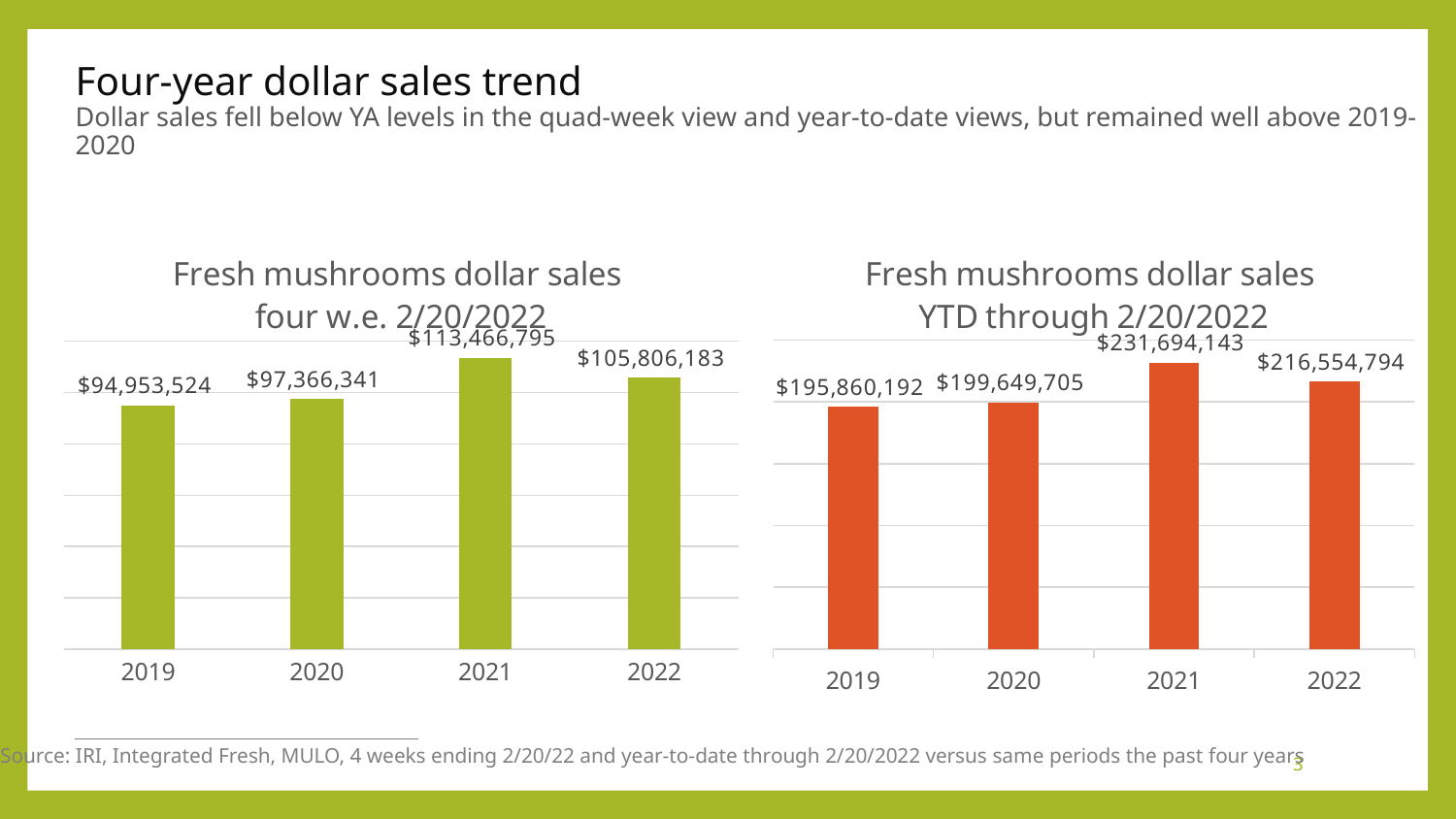
In the 'Fresh mushrooms dollar sales four w.e. 2/20/2022' chart, which year has the lowest value? 2019 In the 'Fresh mushrooms dollar sales four w.e. 2/20/2022' chart, do the values rise or fall from 2019 to 2021? Rise In the 'Fresh mushrooms dollar sales YTD through 2/20/2022' chart, which year has the highest value? 2021 How many years are shown in the 'Fresh mushrooms dollar sales four w.e. 2/20/2022' chart? 4 In the 'Fresh mushrooms dollar sales YTD through 2/20/2022' chart, which is larger, the value for 2020 or the value for 2022? 2022 In the 'Fresh mushrooms dollar sales four w.e. 2/20/2022' chart, what is the value for 2022? $105,806,183 In the 'Fresh mushrooms dollar sales YTD through 2/20/2022' chart, what is the value for 2019? $195,860,192 In the 'Fresh mushrooms dollar sales YTD through 2/20/2022' chart, what is the difference between the 2021 and 2022 values? $15,139,349 In the 'Fresh mushrooms dollar sales four w.e. 2/20/2022' chart, what is the difference between the 2021 and 2022 values? $7,660,612 What kind of chart is the 'Fresh mushrooms dollar sales YTD through 2/20/2022' chart? Bar chart What colour are the bars in the 'Fresh mushrooms dollar sales YTD through 2/20/2022' chart? Orange In the 'Fresh mushrooms dollar sales four w.e. 2/20/2022' chart, what is the value for 2021? $113,466,795